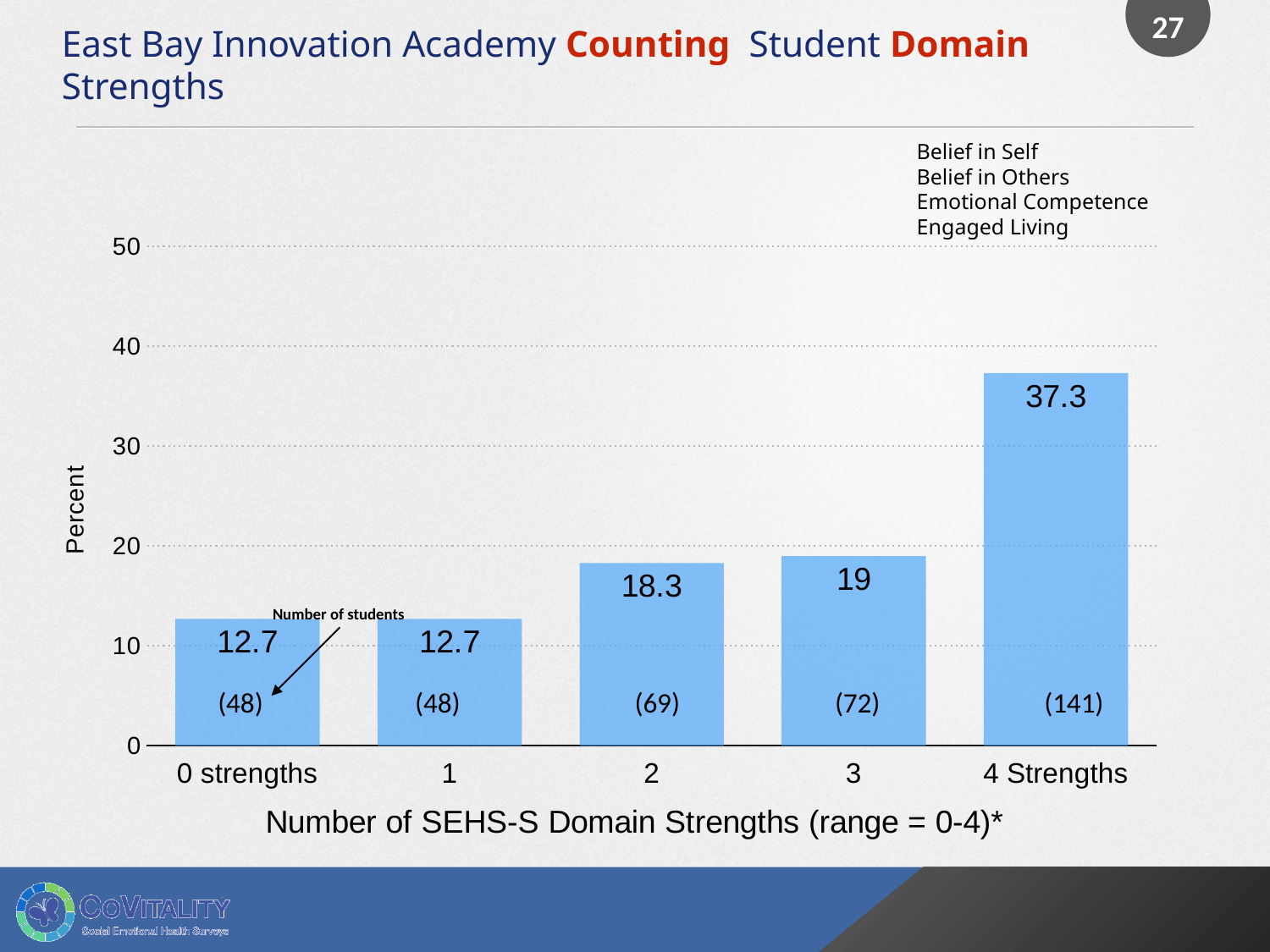
What percent of students have 2 domain strengths? 18.3 What kind of chart is shown on the slide? bar chart Which has a higher percent of students: 2 strengths or 3 strengths? 3 Which number of domain strengths has the highest percent of students? 4 Strengths What is the difference in percent between 4 Strengths and 3 strengths? 18.3 What is the label of the x axis? Number of SEHS-S Domain Strengths (range = 0-4)* How many students have 3 domain strengths, as shown in parentheses? 72 What is the label of the y axis? Percent What percent of students have 4 Strengths? 37.3 Do the percent values rise or fall from 0 strengths to 4 Strengths? rise Is the percent for 4 Strengths greater or less than 40? less How many categories are shown on the x axis? 5